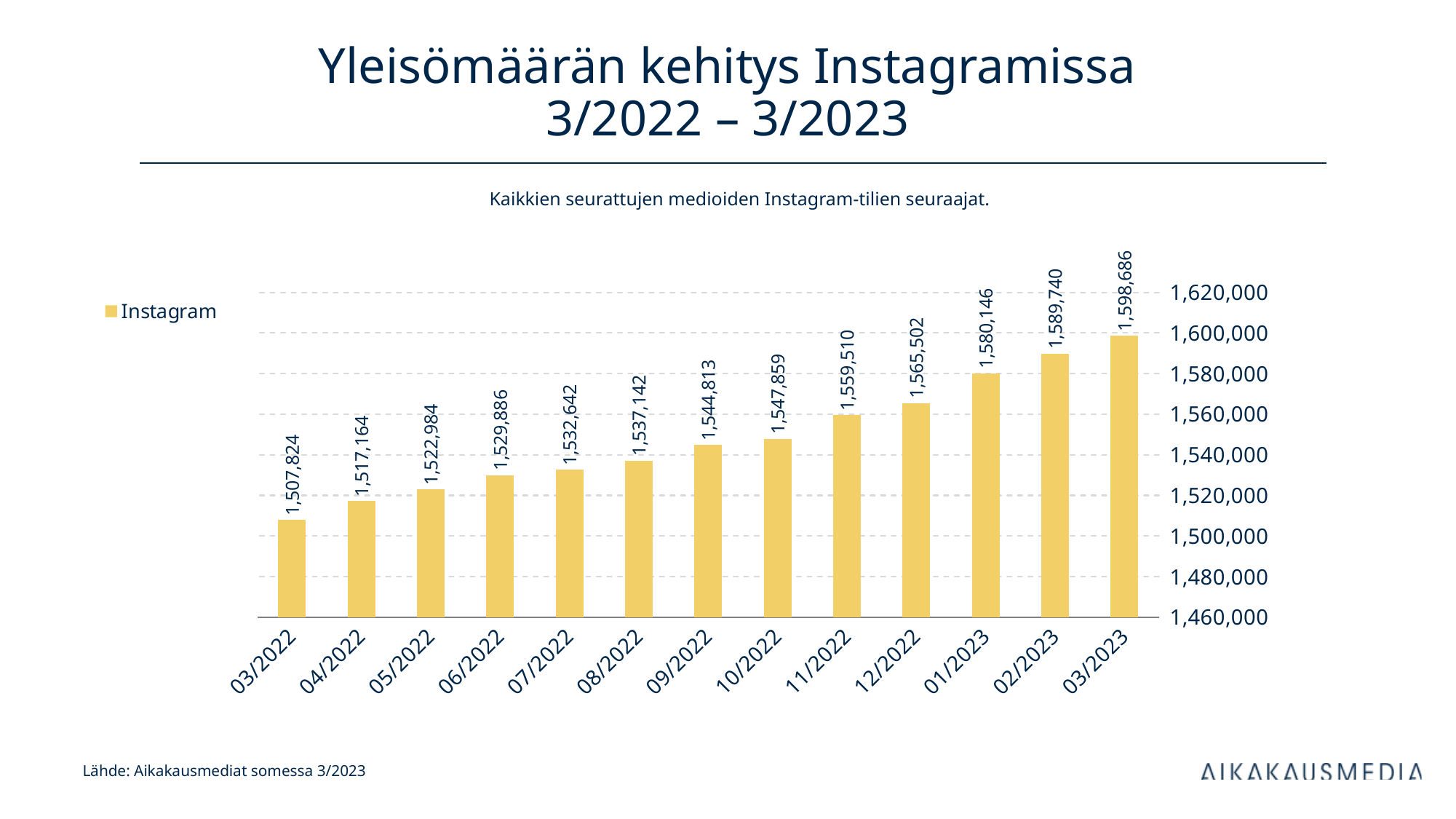
Which month has the highest value? 03/2023 What is the value for 03/2023? 1,598,686 What type of chart is shown on the slide? bar chart What is the value for 03/2022? 1,507,824 What series name does the legend show? Instagram What is the value for 09/2022? 1,544,813 Do the values rise or fall from 03/2022 to 03/2023? rise Which is larger, the value for 11/2022 or the value for 07/2022? 11/2022 Which month has the lowest value? 03/2022 What is the difference between the values for 02/2023 and 01/2023? 9,594 How many months are shown on the x axis? 13 What is the difference between the values for 03/2023 and 03/2022? 90,862